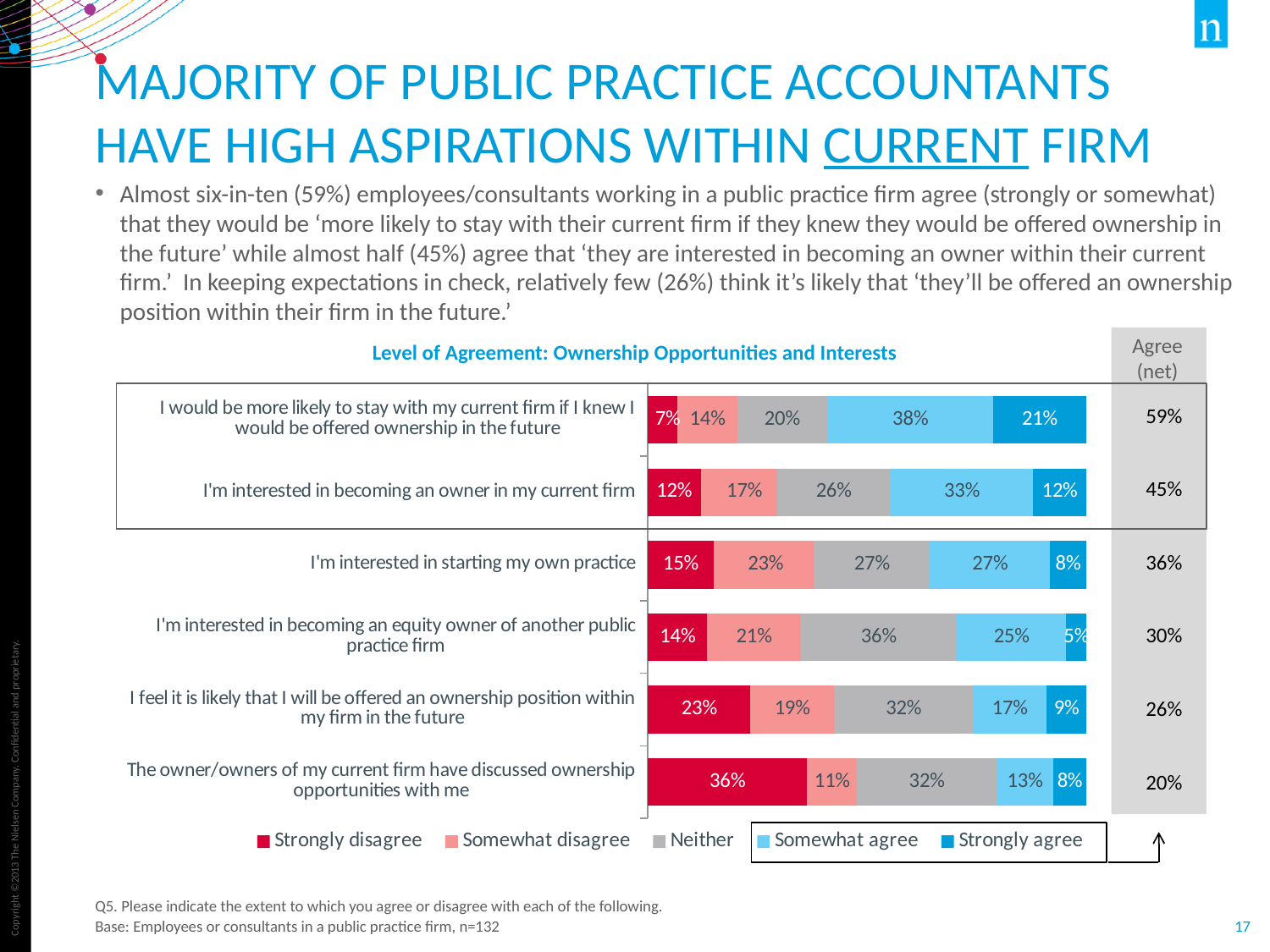
What is the combined 'Somewhat agree' and 'Strongly agree' total for 'I'm interested in starting my own practice'? 35% Which is larger: the 'Strongly disagree' value for 'I feel it is likely that I will be offered an ownership position within my firm in the future' or for 'I'm interested in starting my own practice'? I feel it is likely that I will be offered an ownership position within my firm in the future What is the 'Neither' value for 'I'm interested in becoming an equity owner of another public practice firm'? 36% What is the 'Strongly disagree' value for 'The owner/owners of my current firm have discussed ownership opportunities with me'? 36% How many series does the chart legend list? 5 What is the difference between the 'Somewhat agree' values for 'I'm interested in becoming an owner in my current firm' and 'I feel it is likely that I will be offered an ownership position within my firm in the future'? 16% What is the title of the chart? Level of Agreement: Ownership Opportunities and Interests What type of chart is shown on the slide? Stacked bar chart Which statement has the lowest 'Strongly disagree' value? I would be more likely to stay with my current firm if I knew I would be offered ownership in the future Which statement has the highest 'Strongly agree' value? I would be more likely to stay with my current firm if I knew I would be offered ownership in the future How many statements (categories) are plotted in the chart? 6 What is the 'Somewhat agree' value for 'I would be more likely to stay with my current firm if I knew I would be offered ownership in the future'? 38%